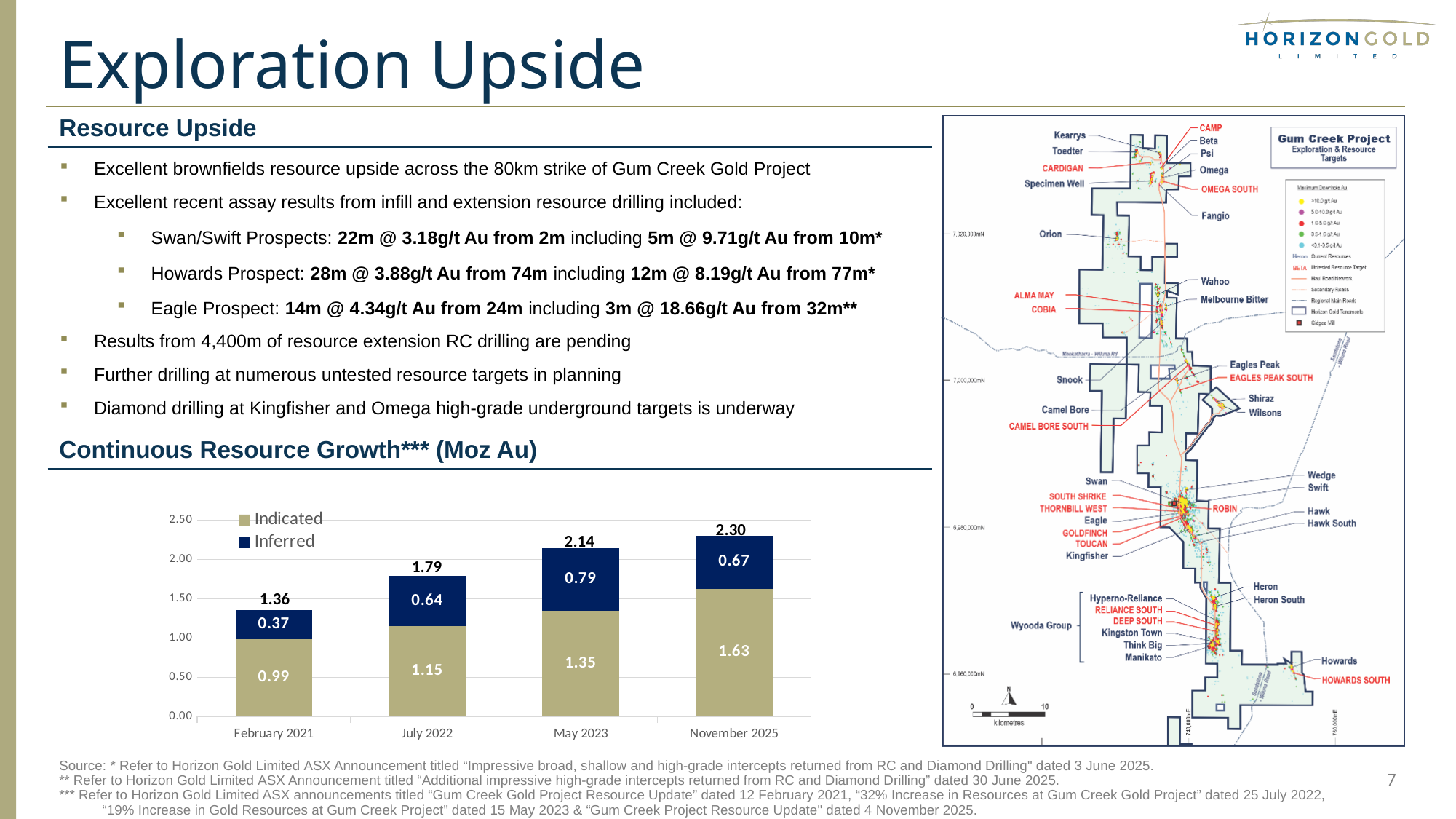
What is the Indicated value for November 2025? 1.63 What kind of chart is used to show Continuous Resource Growth? Stacked bar chart Which period has the lowest Indicated value? February 2021 What is the difference between the total for November 2025 and the total for February 2021? 0.94 What is the Inferred value for July 2022? 0.64 What is the total resource shown above the bar for May 2023? 2.14 How many periods are shown on the x axis? 4 Is the total for July 2022 greater or less than 2.00? less Do the total resource values rise or fall from February 2021 to November 2025? Rise Which is larger, the Inferred value for May 2023 or the Inferred value for November 2025? May 2023 How many series does the legend list? 2 Which period has the highest total resource? November 2025